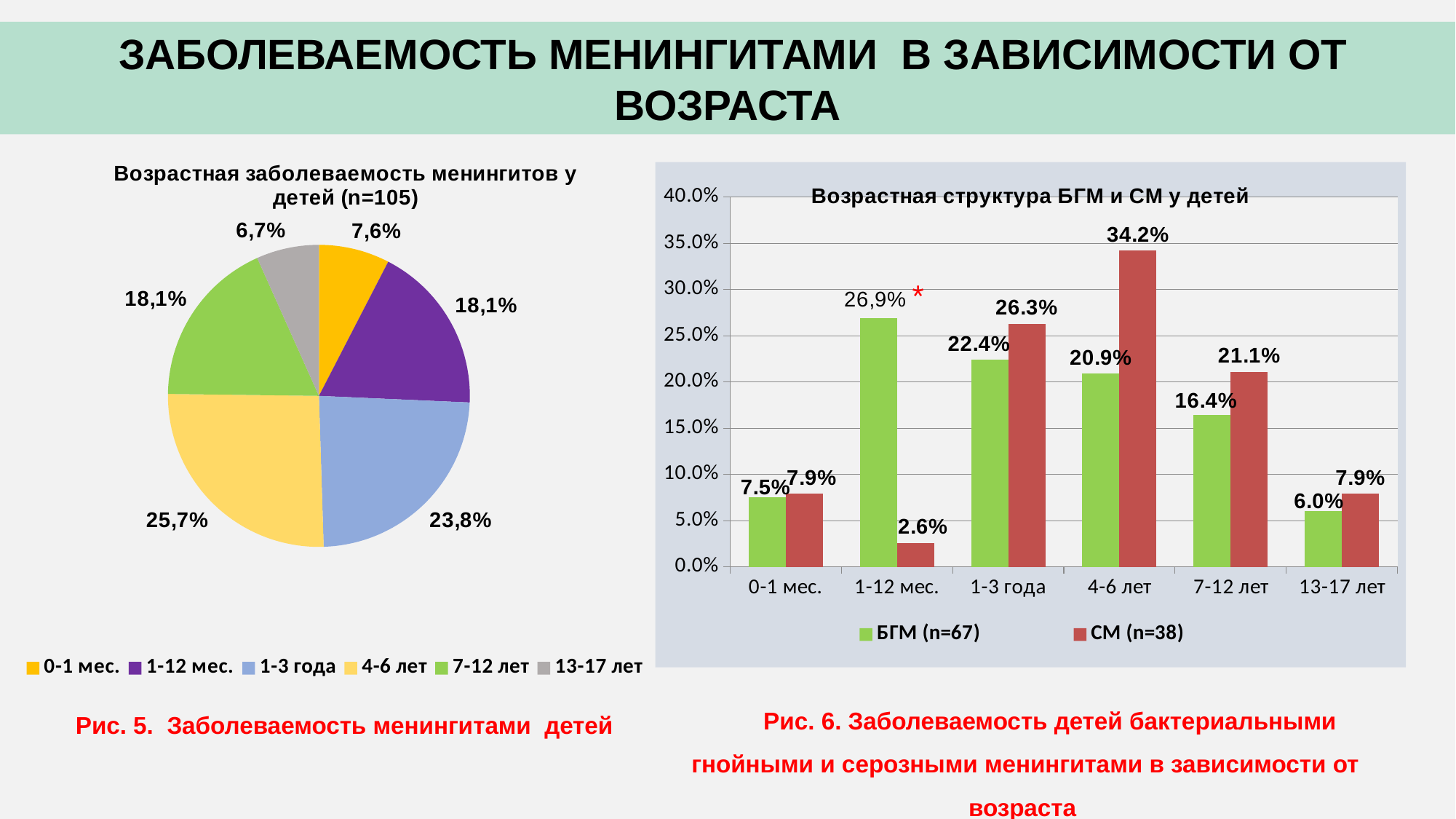
In the bar chart on the right, which age category has the lowest value for СМ? 1-12 мес. In the bar chart on the right, what is the difference between СМ and БГМ in the 4-6 лет category? 13.3% In the bar chart on the right, what is the value for БГМ in the 1-12 мес. category? 26,9% In the bar chart on the right, which age category has the highest value for БГМ? 1-12 мес. In the pie chart on the left, how many age categories are shown? 6 In the pie chart on the left, what share of cases is in the 4-6 лет category? 25,7% In the pie chart on the left, which age category has the smallest share? 13-17 лет What type of chart is the chart on the right? Bar chart In the bar chart on the right, what is the value for СМ in the 4-6 лет category? 34.2% In the bar chart on the right, how many series does the legend list? 2 In the pie chart on the left, which age category has the largest share? 4-6 лет In the pie chart on the left, what is the share for 1-3 года? 23,8%